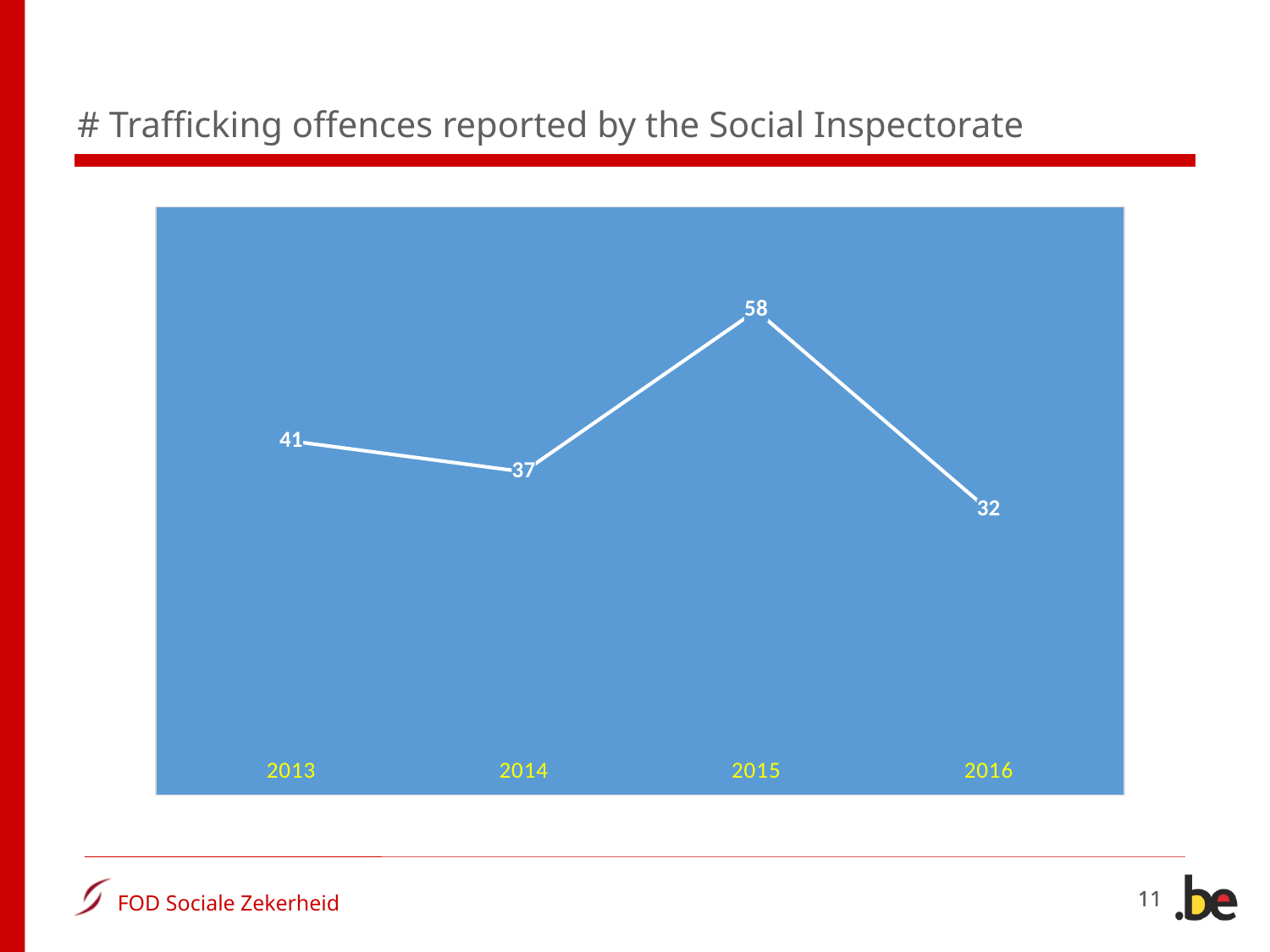
What is the difference between the values for 2013 and 2014? 4 What is the value for 2015? 58 What is the difference between the values for 2015 and 2016? 26 Which year has the highest value? 2015 What is the value for 2014? 37 What is the value for 2013? 41 What is the value for 2016? 32 Does the value rise or fall from 2015 to 2016? fall Which is larger, the value for 2013 or the value for 2016? 2013 Which year has the lowest value? 2016 How many years are plotted on the chart? 4 What kind of chart is shown on the slide? line chart